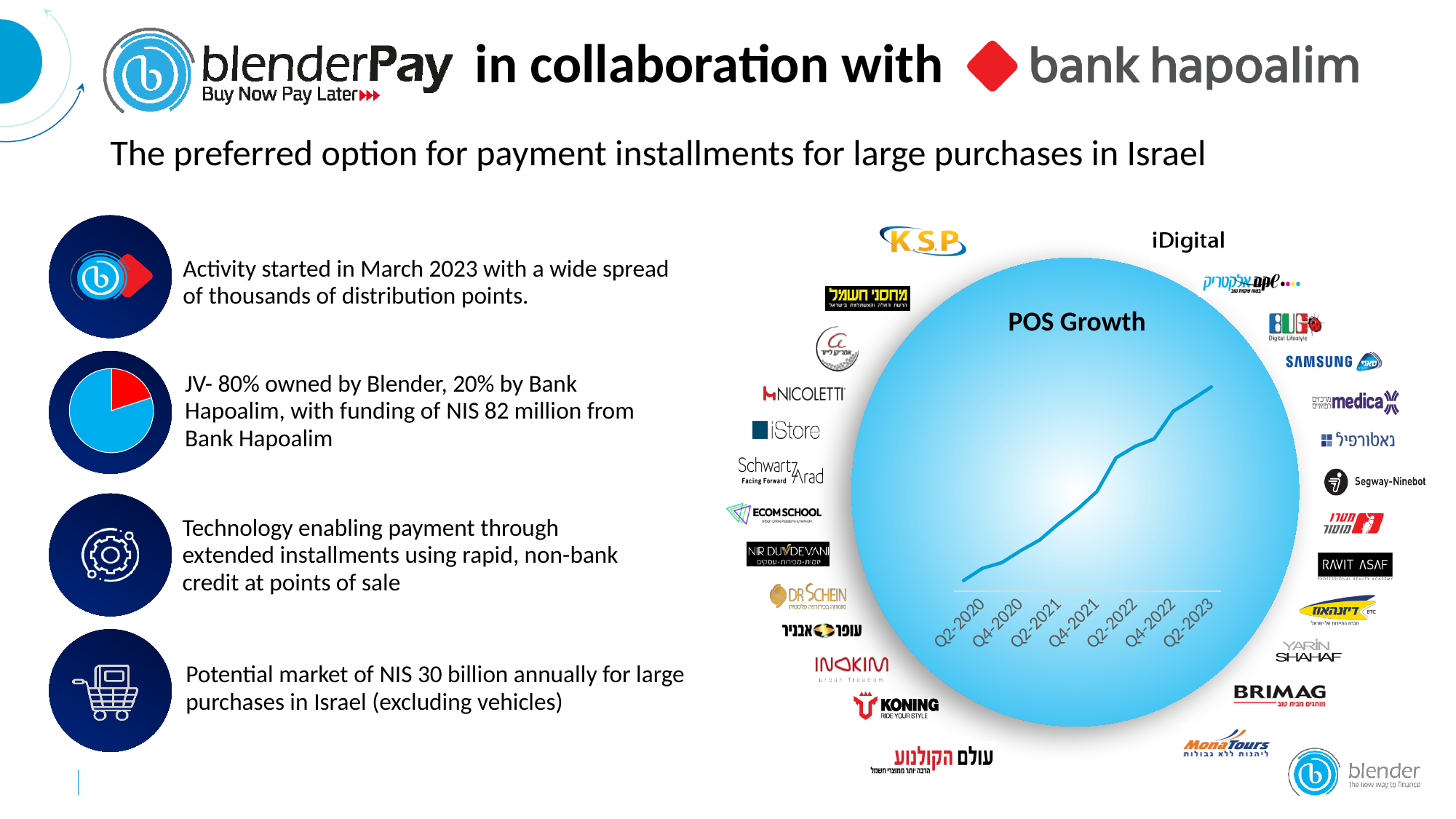
How many quarter labels are shown on the x axis of the POS Growth chart? 7 In the POS Growth chart, which is lower: the value for Q4-2020 or the value for Q4-2021? Q4-2020 Does the line in the POS Growth chart rise or fall from Q2-2020 to Q2-2023? rise Which quarter has the highest value in the POS Growth chart? Q2-2023 What is the first quarter label on the x axis of the POS Growth chart? Q2-2020 Which quarter has the lowest value in the POS Growth chart? Q2-2020 What is the title of the chart inside the blue circle? POS Growth What kind of chart is the POS Growth chart? line chart How many lines are plotted in the POS Growth chart? 1 In the POS Growth chart, which is higher: the value for Q4-2022 or the value for Q2-2021? Q4-2022